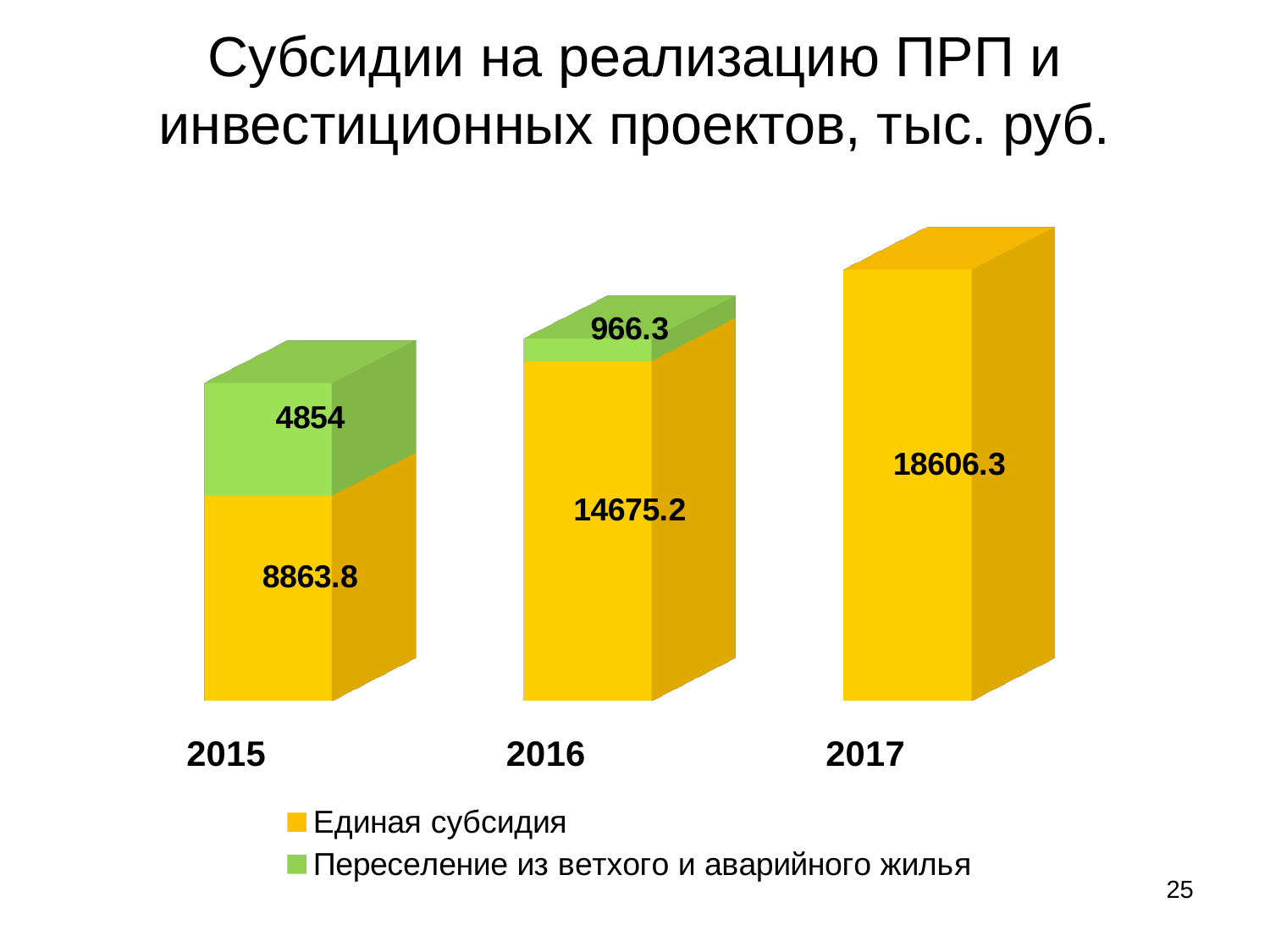
Which is larger: Переселение из ветхого и аварийного жилья in 2015 or in 2016? 2015 What is the total of the stacked bar for 2015? 13717.8 What is the total of the stacked bar for 2016? 15641.5 What is the difference between the Единая субсидия values for 2016 and 2015? 5811.4 What is the value of Единая субсидия for 2015? 8863.8 How many series does the legend list? 2 Which year has the highest value for Единая субсидия? 2017 What is the difference between the Переселение из ветхого и аварийного жилья values for 2015 and 2016? 3887.7 What is the value of Переселение из ветхого и аварийного жилья for 2016? 966.3 How many years are shown on the x axis? 3 What is the value of Единая субсидия for 2017? 18606.3 Which year has the lowest value for Единая субсидия? 2015